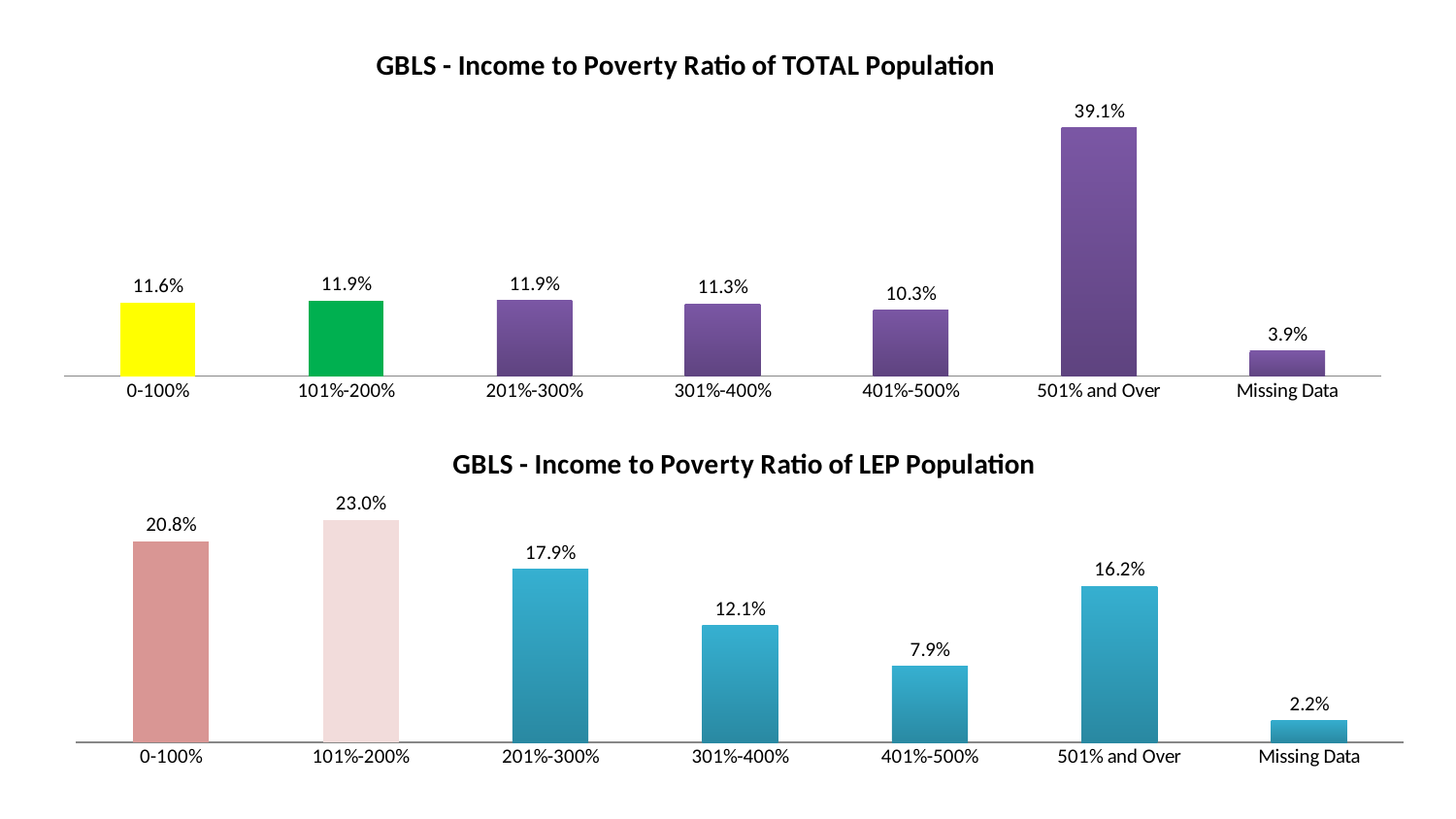
In the 'GBLS - Income to Poverty Ratio of LEP Population' chart, which is larger: 201%-300% or 501% and Over? 201%-300% In the 'GBLS - Income to Poverty Ratio of TOTAL Population' chart, what is the value for 501% and Over? 39.1% In the 'GBLS - Income to Poverty Ratio of LEP Population' chart, what is the difference between the 0-100% value and the 401%-500% value? 12.9% In the 'GBLS - Income to Poverty Ratio of TOTAL Population' chart, which category has the lowest value? Missing Data In the 'GBLS - Income to Poverty Ratio of LEP Population' chart, which category has the highest value? 101%-200% In the 'GBLS - Income to Poverty Ratio of TOTAL Population' chart, what is the difference between the 501% and Over value and the 0-100% value? 27.5% What is the title of the bottom chart on the slide? GBLS - Income to Poverty Ratio of LEP Population In the 'GBLS - Income to Poverty Ratio of LEP Population' chart, what is the value for 101%-200%? 23.0% In the 'GBLS - Income to Poverty Ratio of LEP Population' chart, what is the value for Missing Data? 2.2% In the 'GBLS - Income to Poverty Ratio of TOTAL Population' chart, which is larger: 301%-400% or 401%-500%? 301%-400% How many categories are shown in the 'GBLS - Income to Poverty Ratio of LEP Population' chart? 7 What kind of chart is the 'GBLS - Income to Poverty Ratio of TOTAL Population' chart? Bar chart